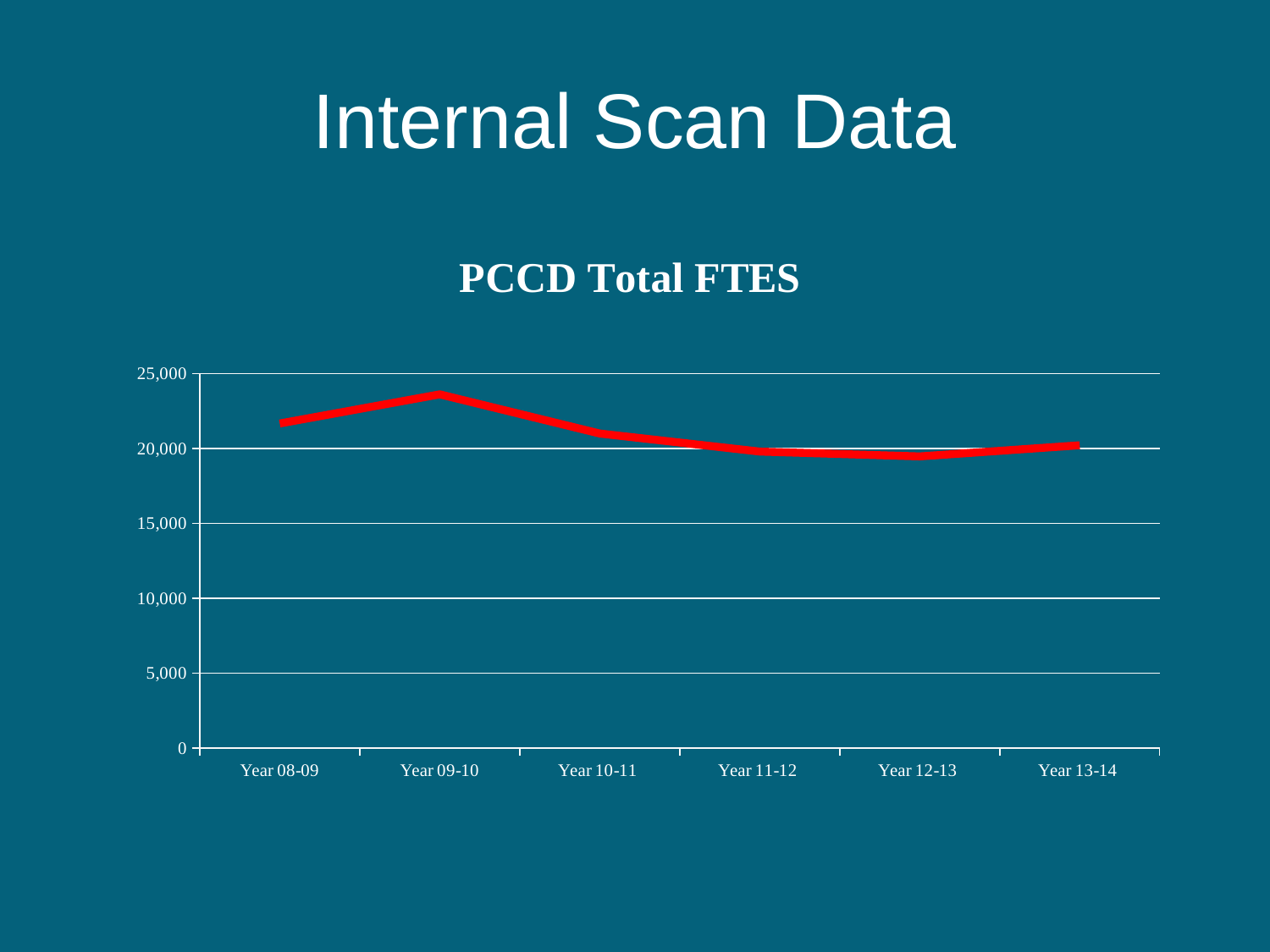
Is the value for Year 08-09 greater or less than 20,000? greater What colour is the line in the chart? red What kind of chart is shown on the slide? line chart What is the title of the chart? PCCD Total FTES Which is larger, the value for Year 09-10 or the value for Year 12-13? Year 09-10 Is the value for Year 10-11 greater or less than 25,000? less Is the value for Year 09-10 greater or less than 20,000? greater How many years are plotted along the x axis? 6 Which year has the highest PCCD Total FTES? Year 09-10 Which is larger, the value for Year 08-09 or the value for Year 11-12? Year 08-09 Do the values rise or fall from Year 09-10 to Year 12-13? fall